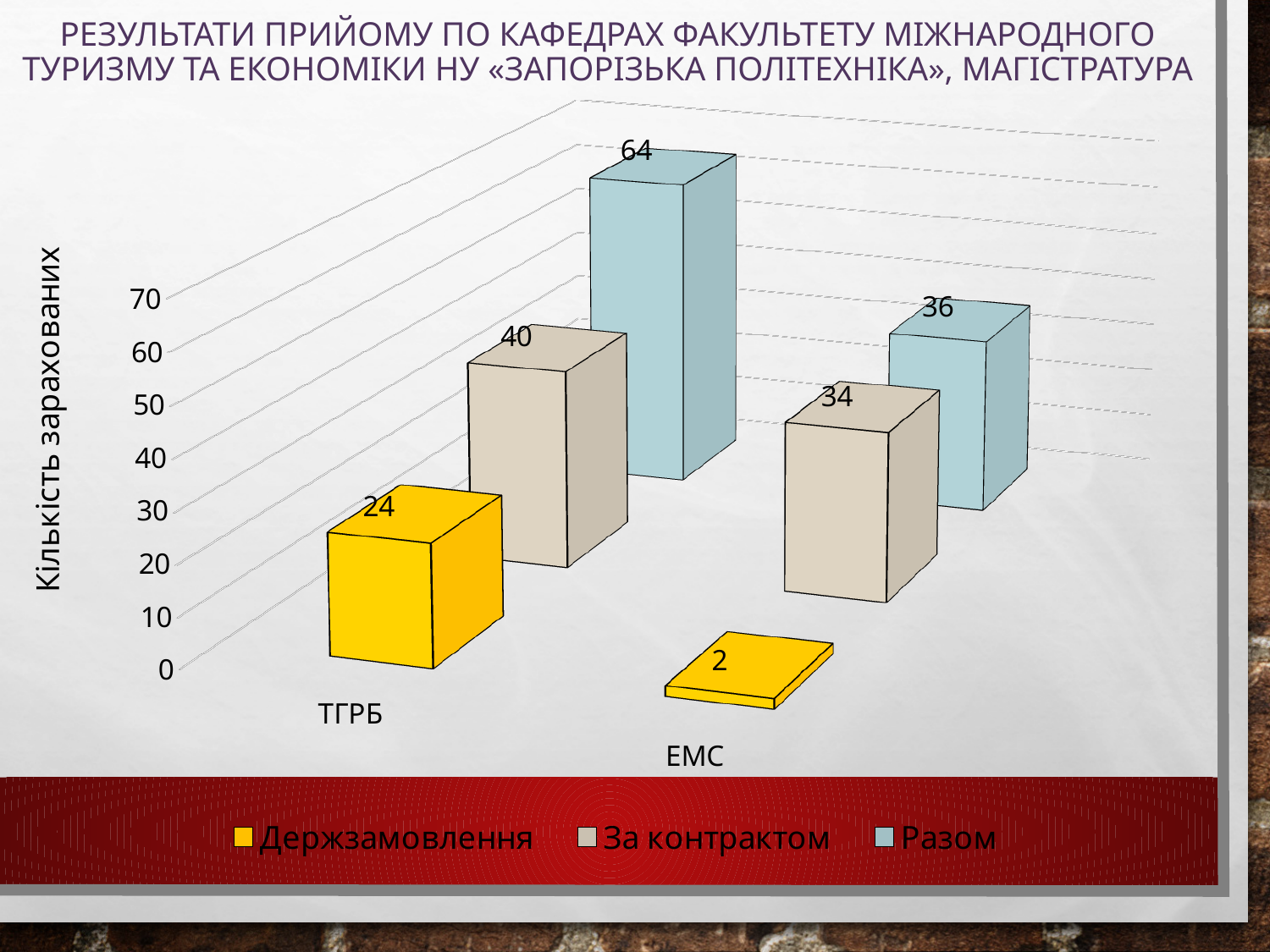
What is the value for За контрактом for ЕМС? 34 What is the value for Держзамовлення for ЕМС? 2 What is the difference between the Разом values for ТГРБ and ЕМС? 28 How many series does the legend list? 3 Which category has the lowest value for Держзамовлення? ЕМС Which category has the highest value for Разом? ТГРБ Which is larger: За контрактом for ТГРБ or За контрактом for ЕМС? ТГРБ How many categories are shown on the x axis? 2 What is the value for Держзамовлення for ТГРБ? 24 What is the value for Разом for ТГРБ? 64 What kind of chart is shown on the slide? bar chart What is the label of the vertical axis? Кількість зарахованих